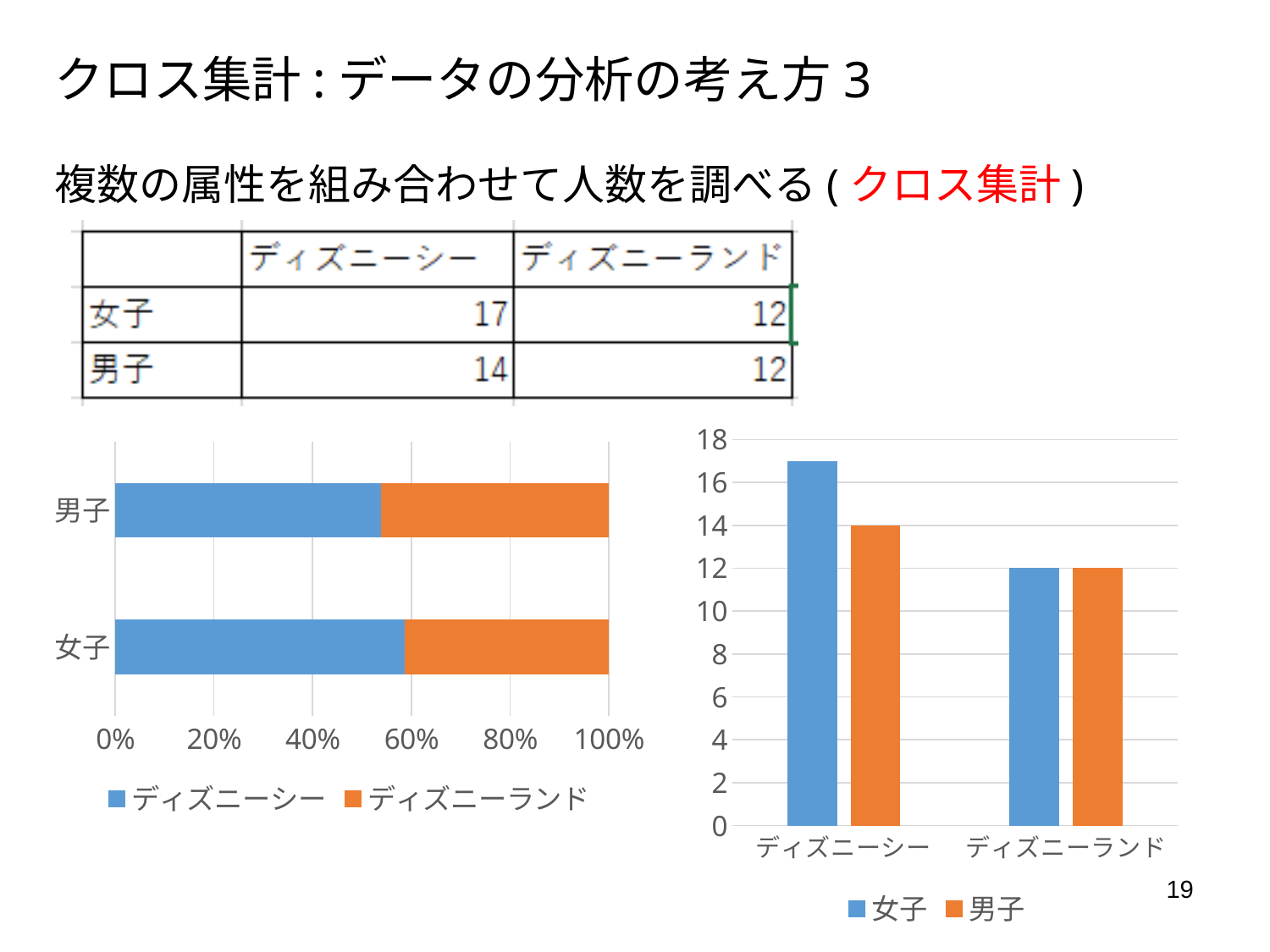
What kind of chart is the chart on the left of the slide? bar chart In the chart on the right, what is the value for 男子 at ディズニーシー? 14 In the chart on the right, what is the difference between the 男子 values for ディズニーシー and ディズニーランド? 2 In the chart on the right, how many categories are shown on the x axis? 2 What kind of chart is the chart on the right of the slide? bar chart In the chart on the right, is the value for 女子 at ディズニーシー greater or less than 16? greater In the chart on the right, how many series does the legend list? 2 In the chart on the right, what is the value for 女子 at ディズニーランド? 12 In the chart on the left, is the ディズニーシー share for 男子 greater or less than 40%? greater In the chart on the right, which is larger at ディズニーシー, 女子 or 男子? 女子 In the chart on the right, which bar is the highest? 女子 at ディズニーシー In the chart on the left, what are the two legend entries? ディズニーシー, ディズニーランド